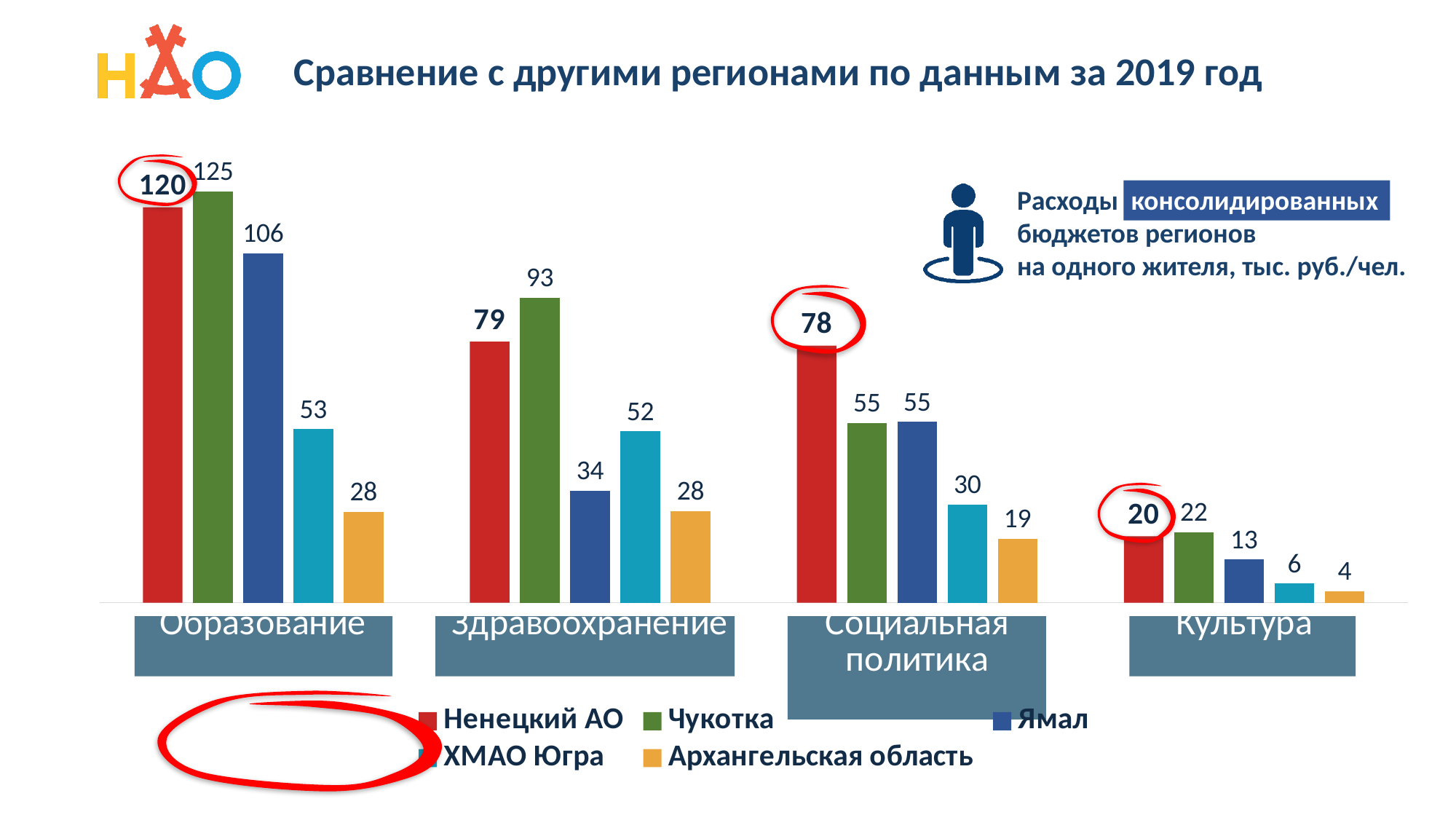
What kind of chart is shown on the slide? Bar chart How many categories are shown on the x axis of the chart? 4 Which is larger in the Здравоохранение category: the value for Ямал or the value for ХМАО Югра? ХМАО Югра Which region has the lowest value in the Культура category? Архангельская область How many series does the chart legend list? 5 Which region has the highest value in the Образование category? Чукотка What is the difference between the Ненецкий АО and Чукотка values in the Социальная политика category? 23 What is the value for Чукотка in the Здравоохранение category? 93 What is the title of the chart on the slide? Сравнение с другими регионами по данным за 2019 год What is the value for Ненецкий АО in the Образование category? 120 Do the values for Ненецкий АО rise or fall from Образование to Культура along the x axis? Fall What is the value for Архангельская область in the Социальная политика category? 19